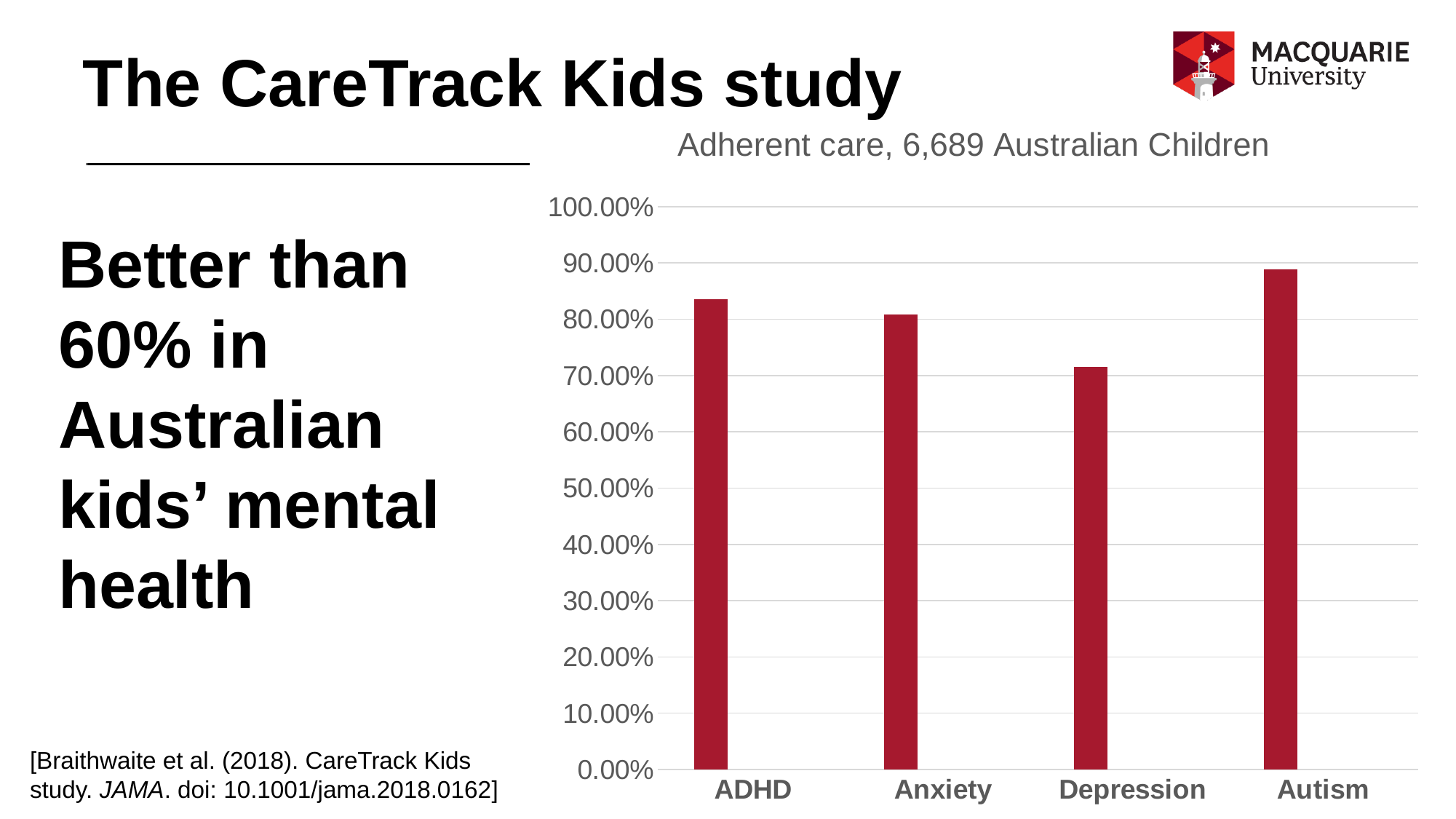
What colour are the bars in the chart? red What is the title of the chart? Adherent care, 6,689 Australian Children Is the value for Depression greater or less than 80.00%? less Is the value for Anxiety greater or less than 70.00%? greater Which has a larger value, Anxiety or Autism? Autism Which category has the highest value in the chart? Autism Which category has the lowest value in the chart? Depression Is the value for ADHD greater or less than 90.00%? less Which has a larger value, ADHD or Depression? ADHD How many categories are shown on the x axis of the chart? 4 What kind of chart is shown on the slide? bar chart